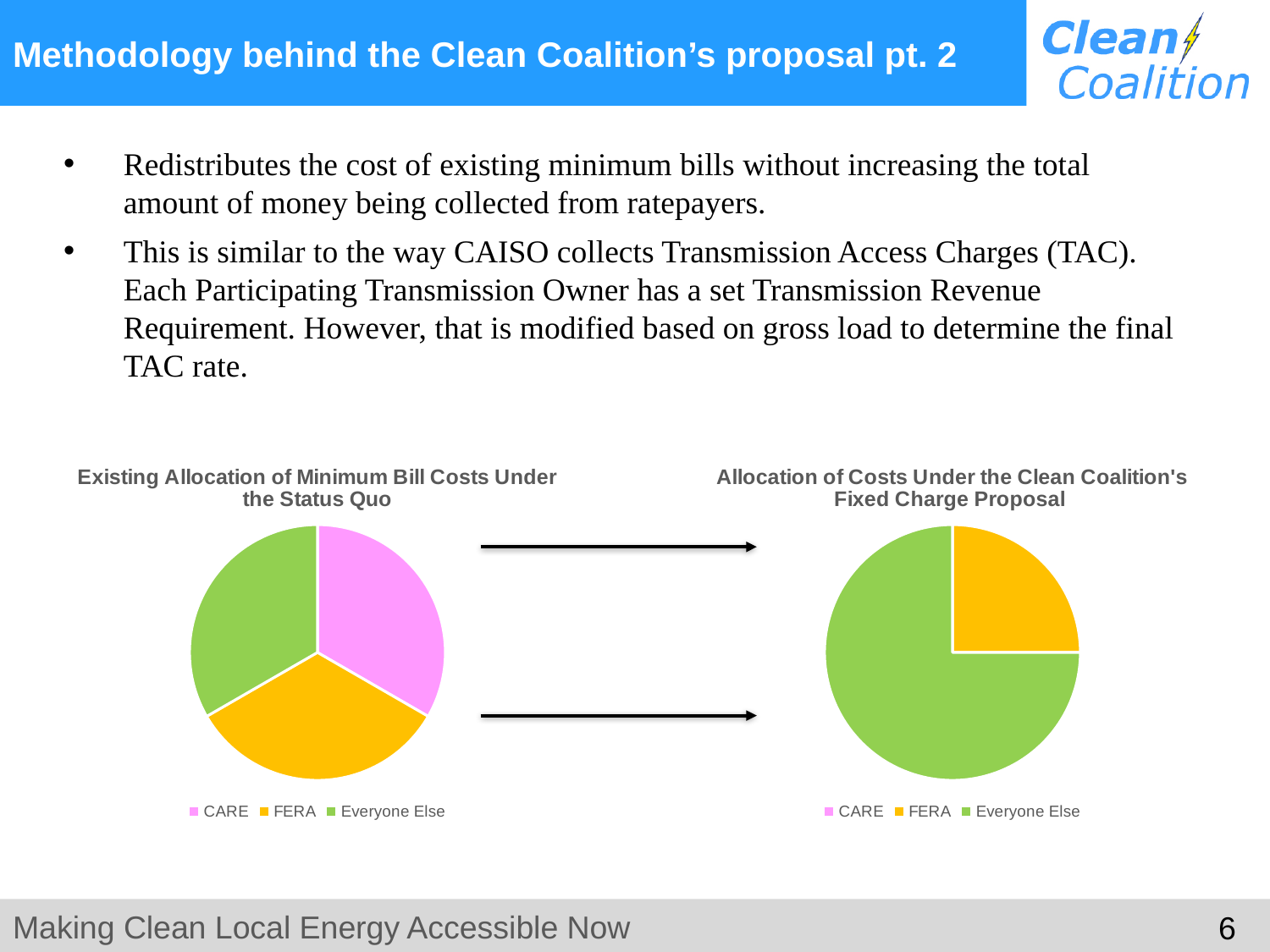
How many entries does the legend of the left pie chart list? 3 What is the title of the pie chart on the left of the slide? Existing Allocation of Minimum Bill Costs Under the Status Quo How many pie charts are shown on the slide? 2 What colour represents FERA in the pie charts? Orange What kind of chart is the "Allocation of Costs Under the Clean Coalition's Fixed Charge Proposal" chart? Pie chart How many entries does the legend of the right pie chart list? 3 In the right pie chart, which is larger: the Everyone Else slice or the FERA slice? Everyone Else In the "Allocation of Costs Under the Clean Coalition's Fixed Charge Proposal" chart, which category has the largest slice? Everyone Else What are the legend entries of the "Existing Allocation of Minimum Bill Costs Under the Status Quo" chart? CARE, FERA, Everyone Else What kind of chart is the "Existing Allocation of Minimum Bill Costs Under the Status Quo" chart? Pie chart